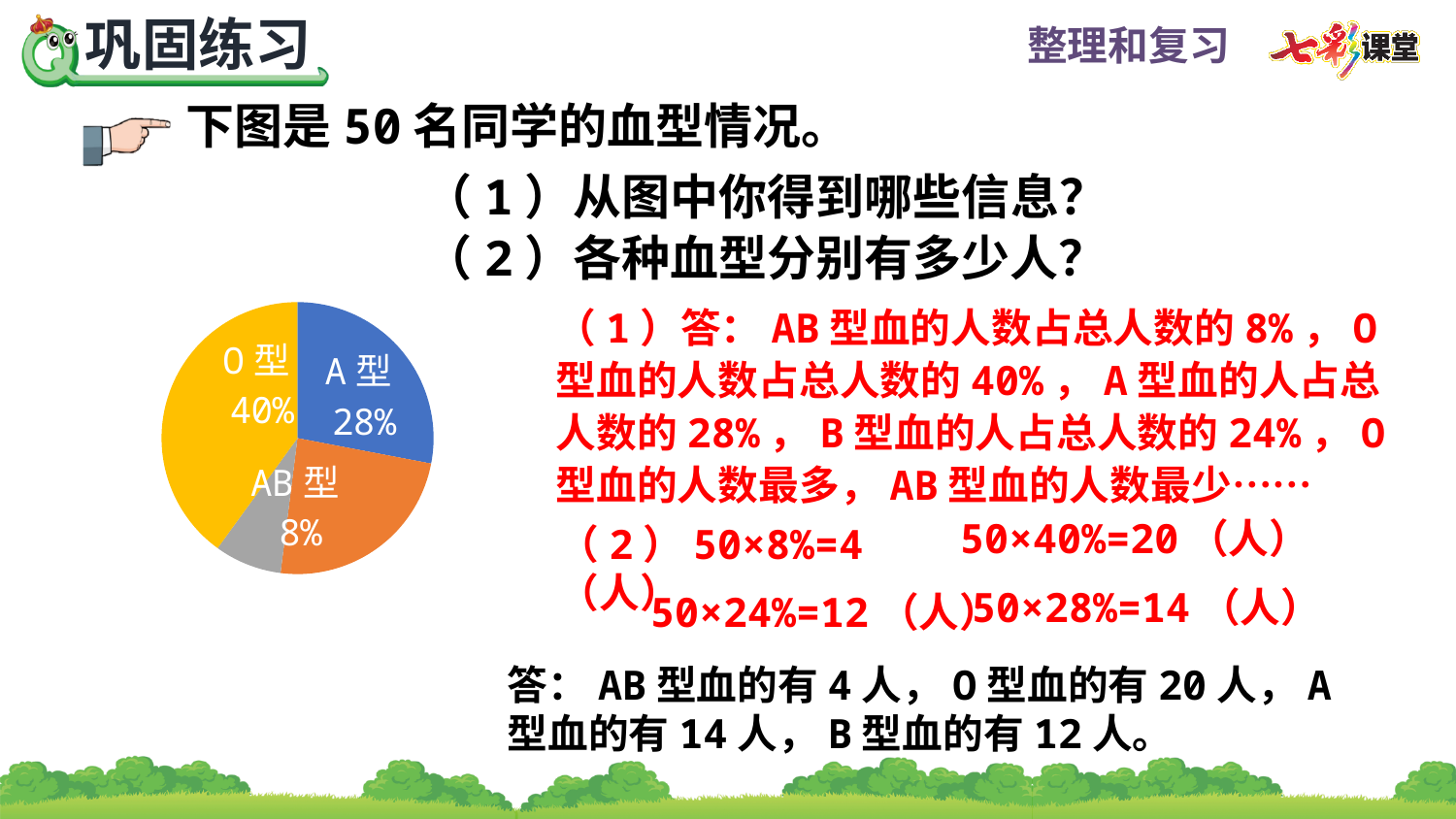
What colour is the O型 slice in the pie chart? yellow What percentage of the pie chart does A型 account for? 28% Which blood type has the smallest slice in the pie chart? AB型 What percentage of the pie chart does AB型 account for? 8% How many slices does the pie chart have? 4 Which slice is larger, A型 or AB型? A型 What is the difference in percentage points between the O型 slice and the A型 slice? 12% What is the difference in percentage points between the A型 slice and the AB型 slice? 20% What percentage of the pie chart does O型 account for? 40% Which blood type has the largest slice in the pie chart? O型 According to the slide, what percentage of the total does B型 account for? 24% What kind of chart is shown on the slide? pie chart